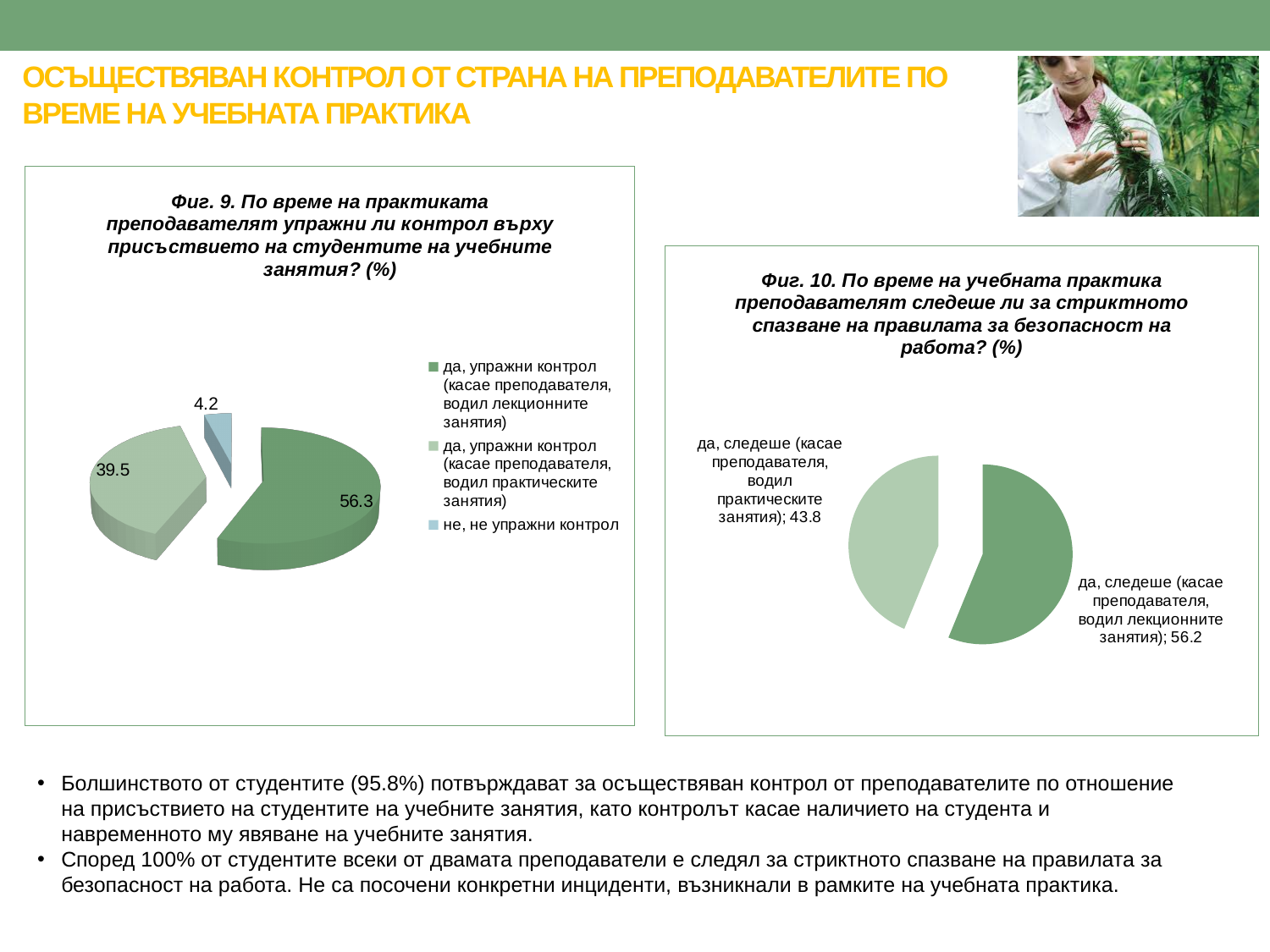
In the chart titled "Фиг. 10", what value is shown for "да, следеше (касае преподавателя, водил практическите занятия)"? 43.8 In the chart titled "Фиг. 9", what value is shown for "да, упражни контрол (касае преподавателя, водил практическите занятия)"? 39.5 What type of chart is the chart titled "Фиг. 9"? pie chart In the chart titled "Фиг. 10", what value is shown for "да, следеше (касае преподавателя, водил лекционните занятия)"? 56.2 In the chart titled "Фиг. 9", which category has the largest slice? да, упражни контрол (касае преподавателя, водил лекционните занятия) In the chart titled "Фиг. 9", what value is shown for the slice "не, не упражни контрол"? 4.2 In the chart titled "Фиг. 9", which category has the smallest slice? не, не упражни контрол In the chart titled "Фиг. 9", what is the difference between the largest slice (56.3) and the slice for the practical-classes lecturer (39.5)? 16.8 How many categories does the legend of the chart titled "Фиг. 9" list? 3 In the chart titled "Фиг. 10", which of the two slices is larger: the one for the lecturer of lecture classes or the one for the lecturer of practical classes? the lecturer of lecture classes (56.2) In the chart titled "Фиг. 10", what is the difference between the two slice values? 12.4 How many slices does the chart titled "Фиг. 10" have? 2